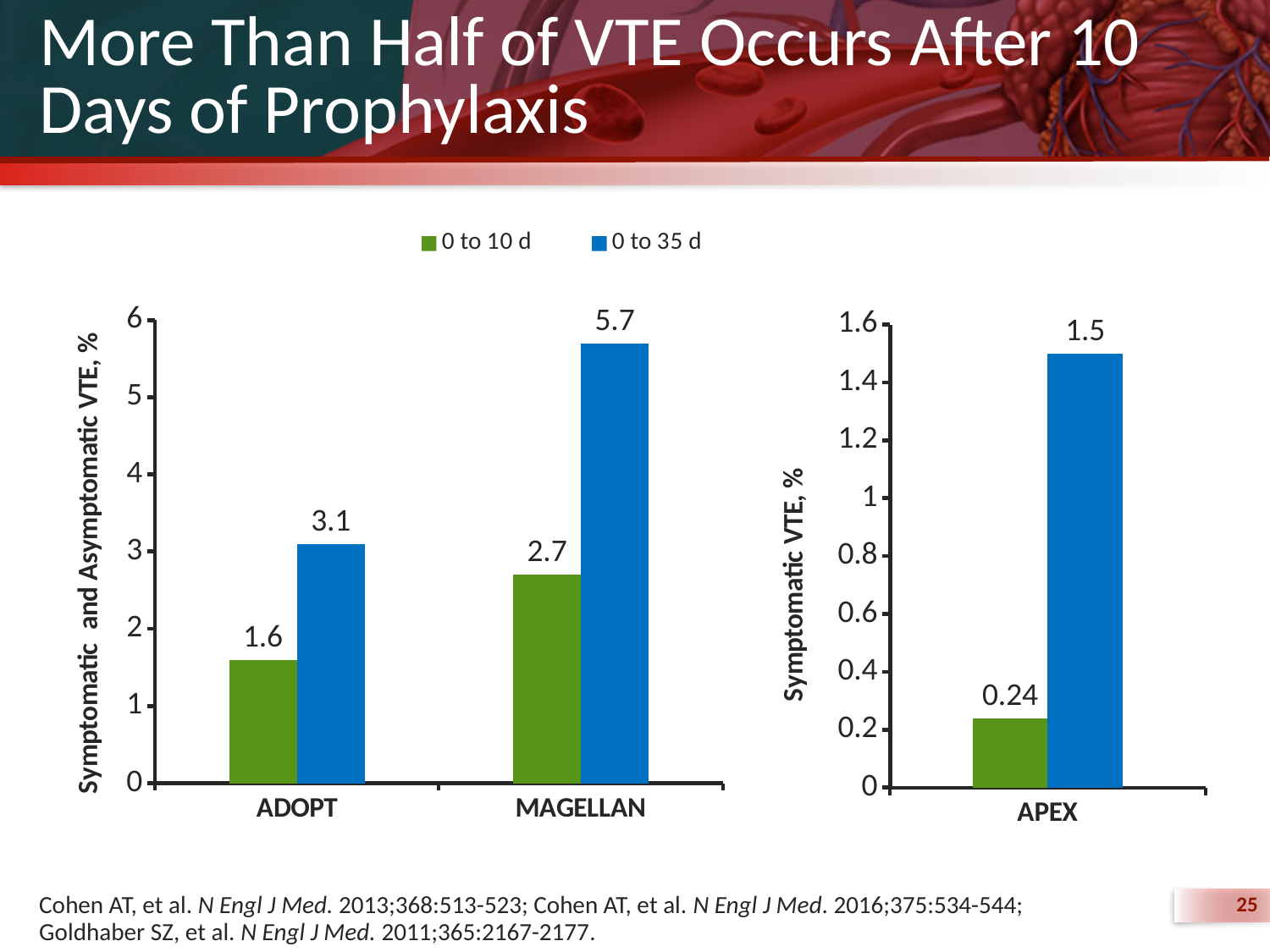
In the left chart (ADOPT and MAGELLAN), what is the difference between the 0 to 35 d and 0 to 10 d values for MAGELLAN? 3.0 How many series does the legend list? 2 In the left chart (ADOPT and MAGELLAN), which bar is the lowest? ADOPT, 0 to 10 d In the left chart (ADOPT and MAGELLAN), what is the value for the 0 to 10 d series for ADOPT? 1.6 In the right chart (APEX), what is the value for the 0 to 35 d series? 1.5 What kind of chart is the right chart (APEX)? Bar chart What is the y-axis label of the right chart (APEX)? Symptomatic VTE, % In the right chart (APEX), what is the value for the 0 to 10 d series? 0.24 In the left chart (ADOPT and MAGELLAN), what is the value for the 0 to 35 d series for MAGELLAN? 5.7 In the left chart (ADOPT and MAGELLAN), which is larger: the 0 to 10 d value for MAGELLAN or the 0 to 35 d value for ADOPT? 0 to 35 d value for ADOPT In the left chart (ADOPT and MAGELLAN), what is the difference between the 0 to 35 d and 0 to 10 d values for ADOPT? 1.5 In the left chart (ADOPT and MAGELLAN), which bar is the highest? MAGELLAN, 0 to 35 d